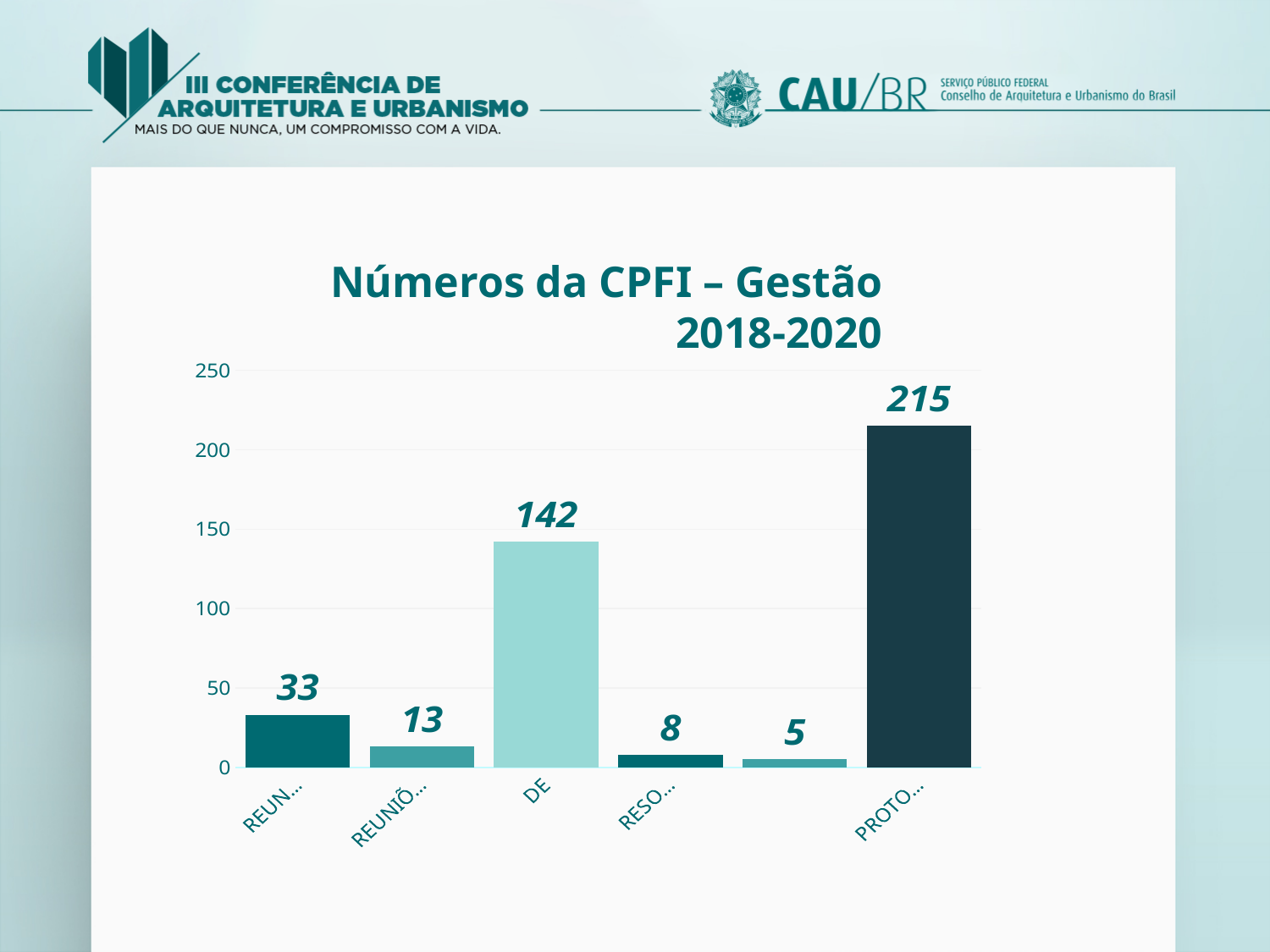
What is the title of the chart? Números da CPFI – Gestão 2018-2020 How many bars are plotted in the chart? 6 What is the value of the first bar from the left? 33 Which is larger, the first bar (33) or the second bar (13)? the first bar (33) What is the value of the third bar from the left? 142 Which bar has the highest value? the last bar on the right (215) Is the value of the third bar from the left greater or less than 100? greater What is the value of the fifth bar from the left? 5 What kind of chart is shown on the slide? bar chart Which bar has the lowest value? the fifth bar from the left (5) What is the difference between the highest bar (215) and the third bar (142)? 73 What is the value of the last bar on the right? 215